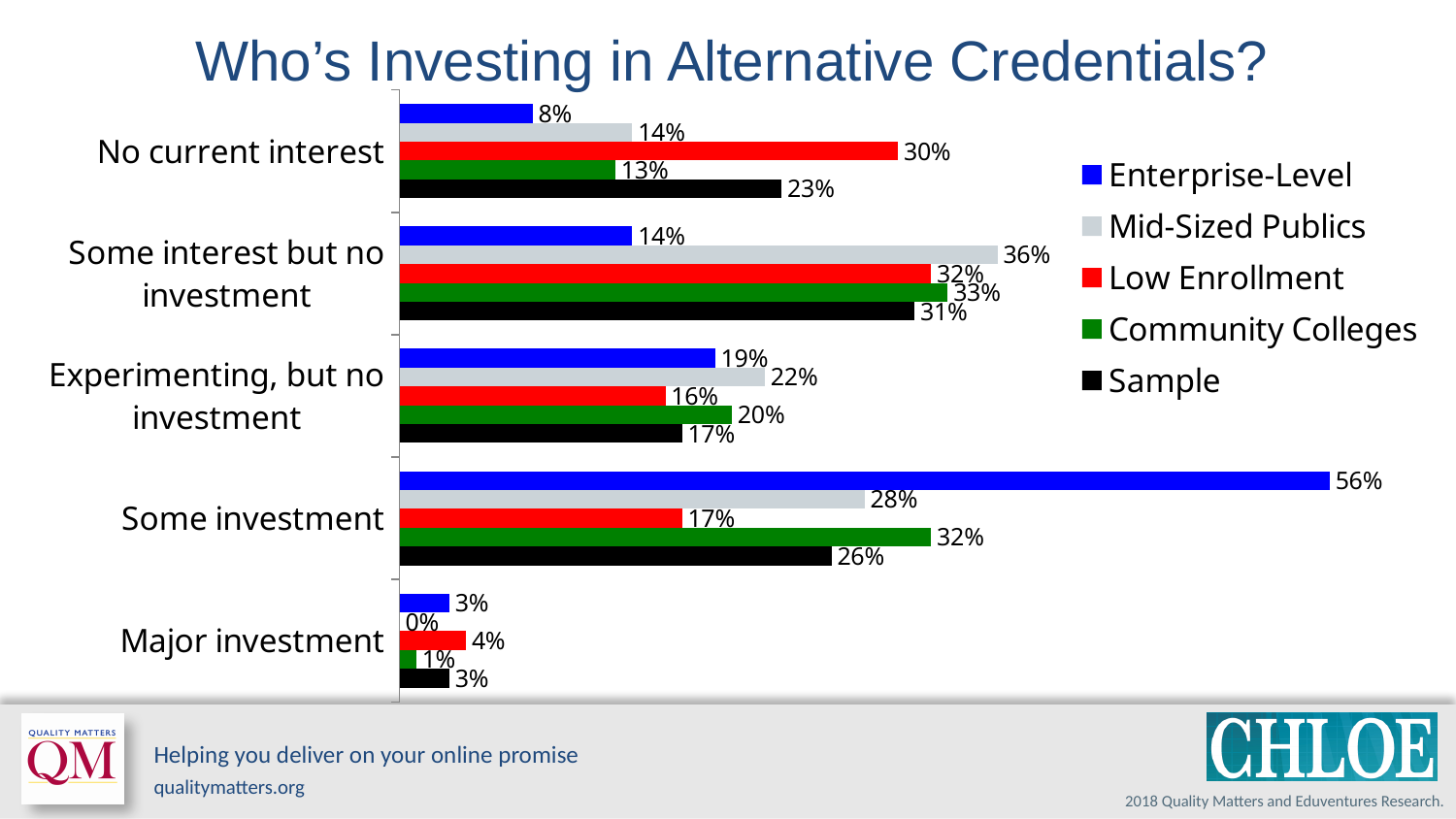
What is the Enterprise-Level value for Some investment? 56% What is the Low Enrollment value for No current interest? 30% What kind of chart is shown on the slide? Bar chart How many series does the legend list? 5 For No current interest, which is larger: the Low Enrollment value or the Sample value? Low Enrollment What is the difference between the Enterprise-Level and Sample values for Some investment? 30% What is the Mid-Sized Publics value for Some interest but no investment? 36% Which series has the lowest value for Major investment? Mid-Sized Publics What colour represents the Community Colleges series? Green Which category has the highest Enterprise-Level value? Some investment What is the Community Colleges value for Experimenting, but no investment? 20% How many categories are shown on the chart? 5